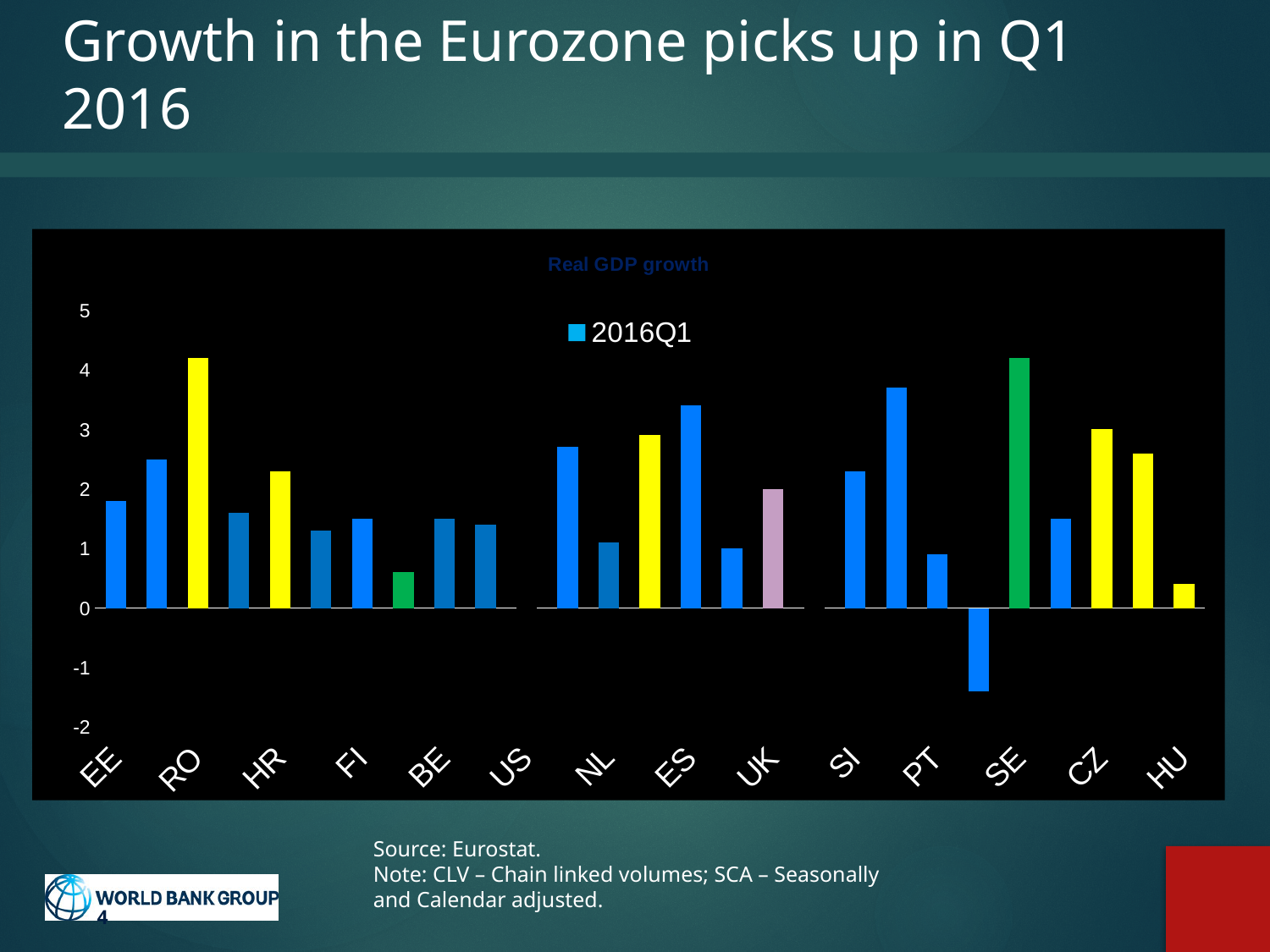
How many country labels are shown on the x axis of the chart? 14 What kind of chart is shown on the slide? bar chart Is the value for EE greater or less than 1? greater Is the value for SE greater or less than 3? greater Is the value for HU greater or less than 1? less What is the title of the chart? Real GDP growth What is the series name shown in the chart legend? 2016Q1 How many series does the chart legend list? 1 Which has the larger value, SE or HU? SE Which has the larger value, ES or UK? ES